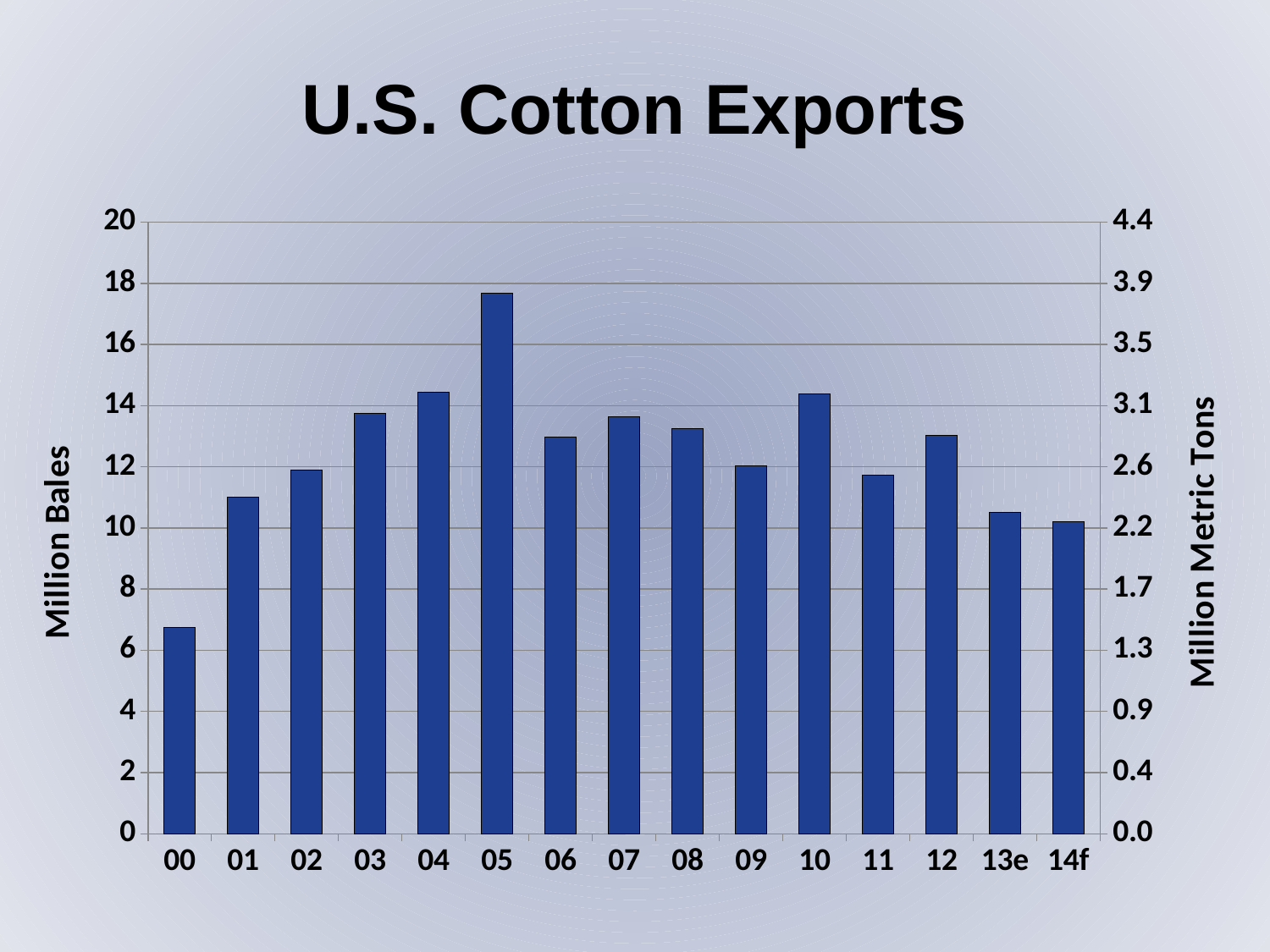
Do the values rise or fall from 00 to 05? rise Is the value for 05 greater or less than 16 million bales? greater What type of chart is shown on the slide? bar chart Which year has the lowest cotton exports? 00 Is the value for 09 greater or less than 10 million bales? greater Which is larger, the value for 04 or the value for 05? 05 Which year has the highest cotton exports? 05 What is the title of the chart? U.S. Cotton Exports Is the value for 00 greater or less than 8 million bales? less What is the label of the left vertical axis? Million Bales How many years (categories) are shown on the x axis? 15